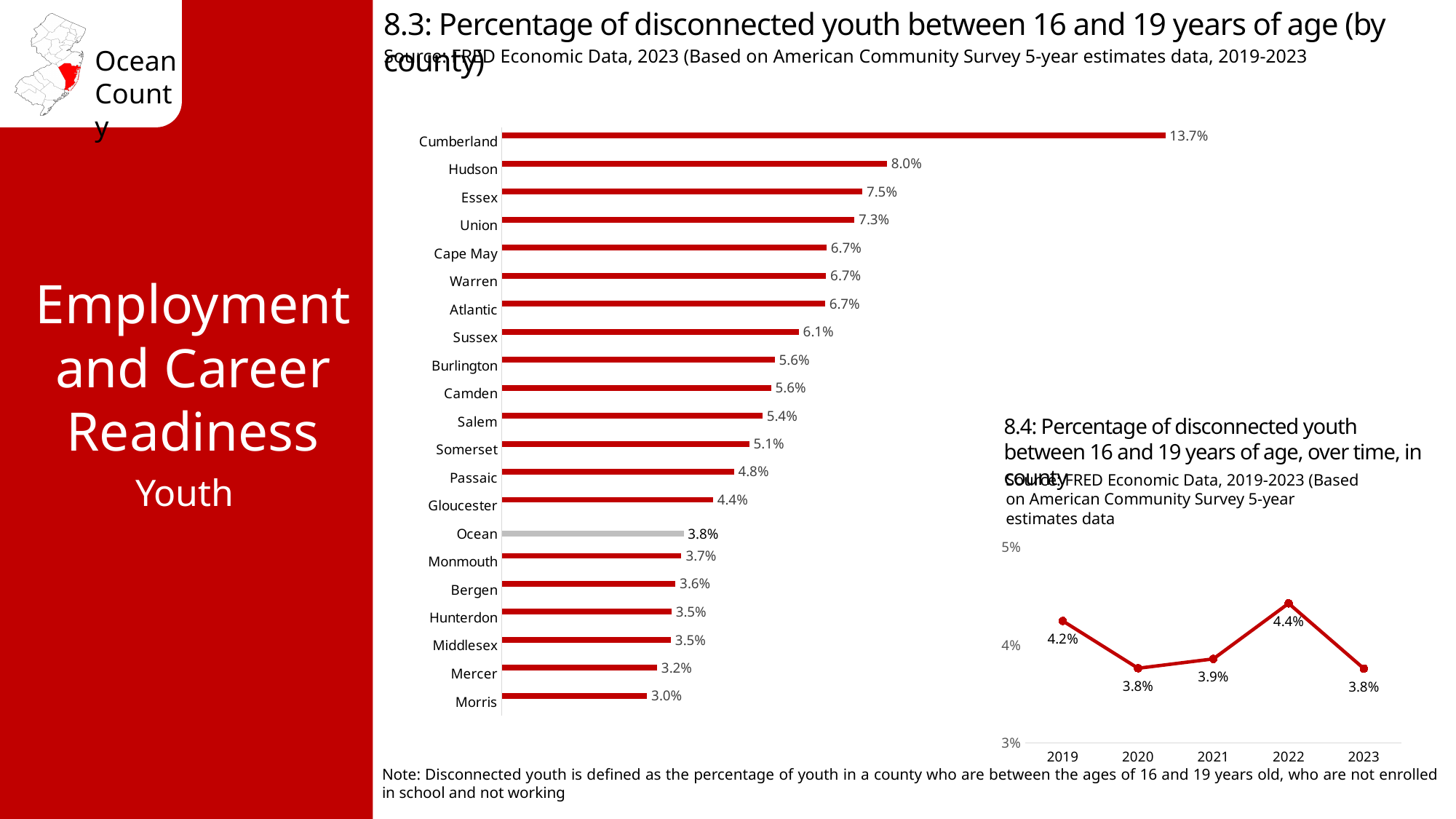
In the 8.4 chart (over time), what is the difference between the 2022 and 2023 values? 0.6% In the 8.3 chart (by county), which has a higher percentage of disconnected youth, Essex or Union? Essex In the 8.3 chart (by county), what is the percentage of disconnected youth for Ocean County? 3.8% In the 8.3 chart (by county), what is the percentage of disconnected youth for Passaic? 4.8% In the 8.3 chart (by county), what is the difference between Cumberland's and Hudson's percentages? 5.7% What kind of chart is the 8.3 chart (by county)? Bar chart In the 8.3 chart (by county), which county has the highest percentage of disconnected youth? Cumberland In the 8.3 chart (by county), which county has the lowest percentage of disconnected youth? Morris In the 8.3 chart (by county), how many counties are shown? 21 In the 8.4 chart (over time), which year had the highest percentage of disconnected youth? 2022 In the 8.4 chart (over time), how many years are plotted? 5 In the 8.4 chart (over time), what was the percentage of disconnected youth in 2022? 4.4%